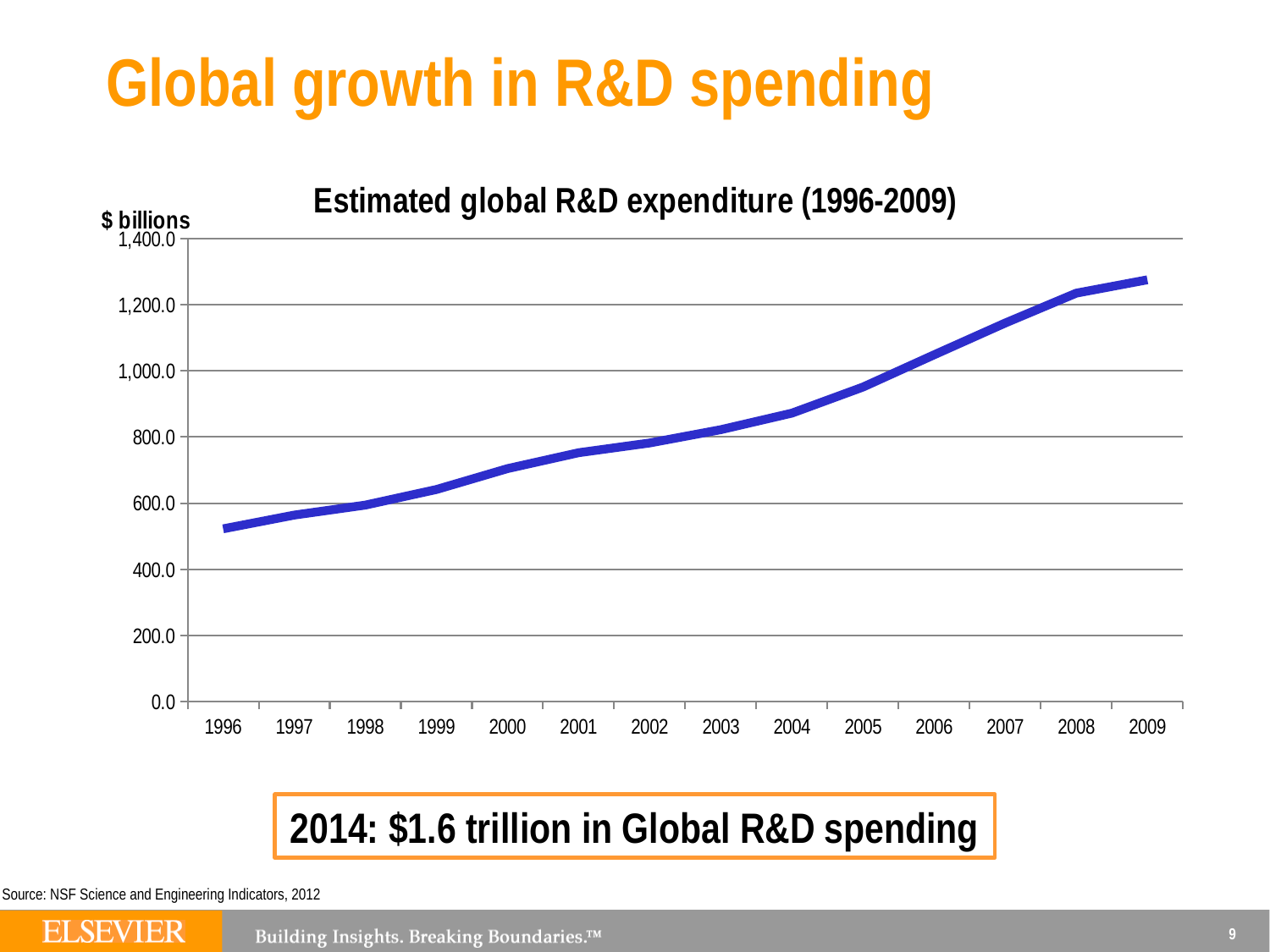
Which year has the lowest estimated global R&D expenditure? 1996 Do the values rise or fall from 1996 to 2009? rise Is the value for 1996 greater or less than 600? less What unit is shown on the vertical axis of the chart? $ billions Is the value for 2005 greater or less than 1,000? less Is the value for 2001 greater or less than 800? less Which year has the larger value, 2000 or 2006? 2006 Which year has the highest estimated global R&D expenditure? 2009 How many years are plotted on the x axis of the chart? 14 What kind of chart is shown on the slide? line chart What is the title of the chart? Estimated global R&D expenditure (1996-2009)